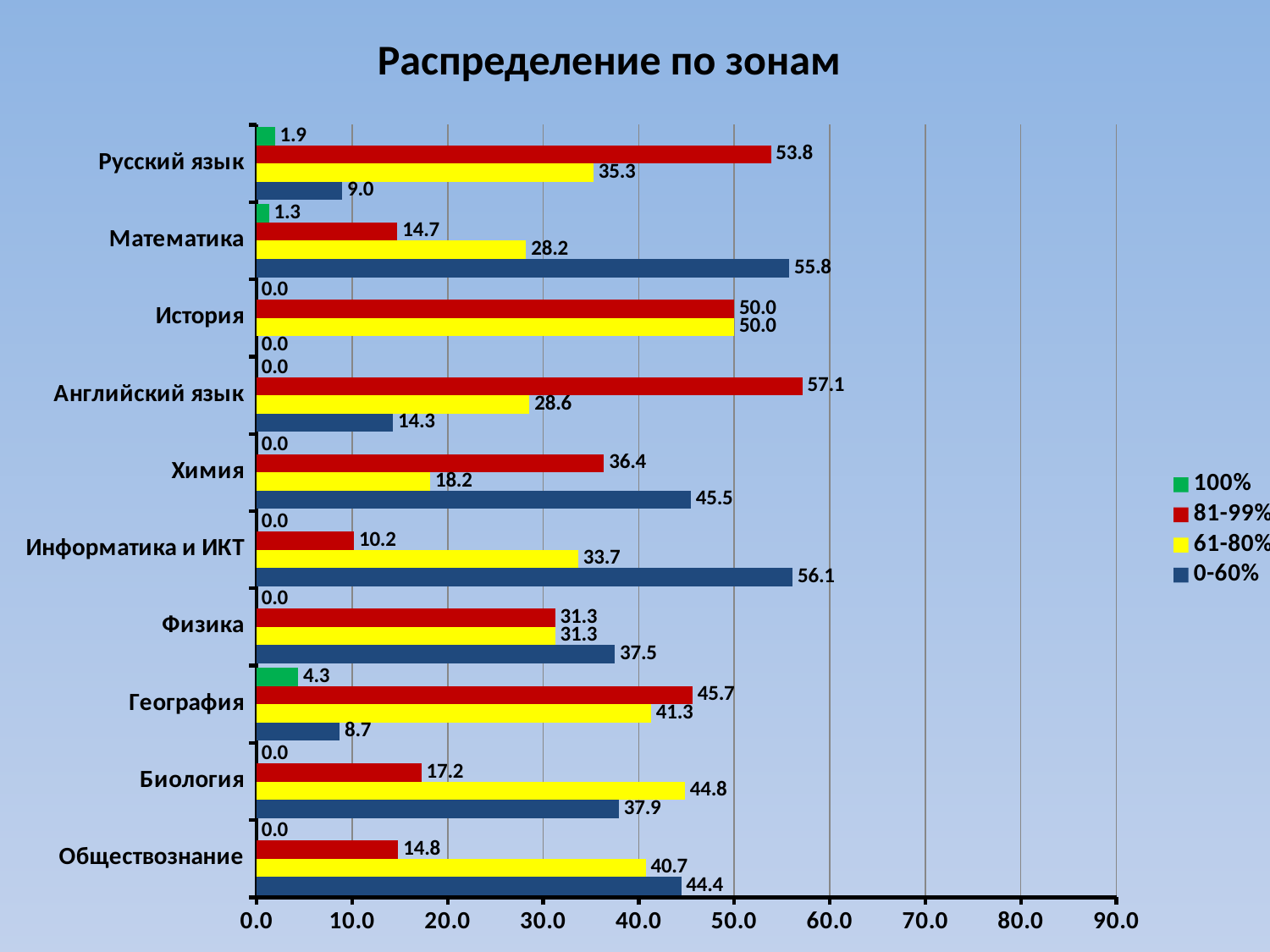
What is the value for the 100% series for География? 4.3 What is the value for the 81-99% series for Русский язык? 53.8 Is the 0-60% value for Химия greater or less than 40.0? greater Which category has the highest value in the 81-99% series? Английский язык How many categories (subjects) are shown on the chart? 10 What is the difference between the 81-99% value and the 0-60% value for Русский язык? 44.8 How many series does the legend list? 4 Which category has the lowest non-zero value in the 61-80% series? Химия What is the value for the 0-60% series for Математика? 55.8 What kind of chart is shown on the slide? Bar chart What is the value for the 61-80% series for Биология? 44.8 For Биология, which is larger: the 61-80% value or the 0-60% value? 61-80%